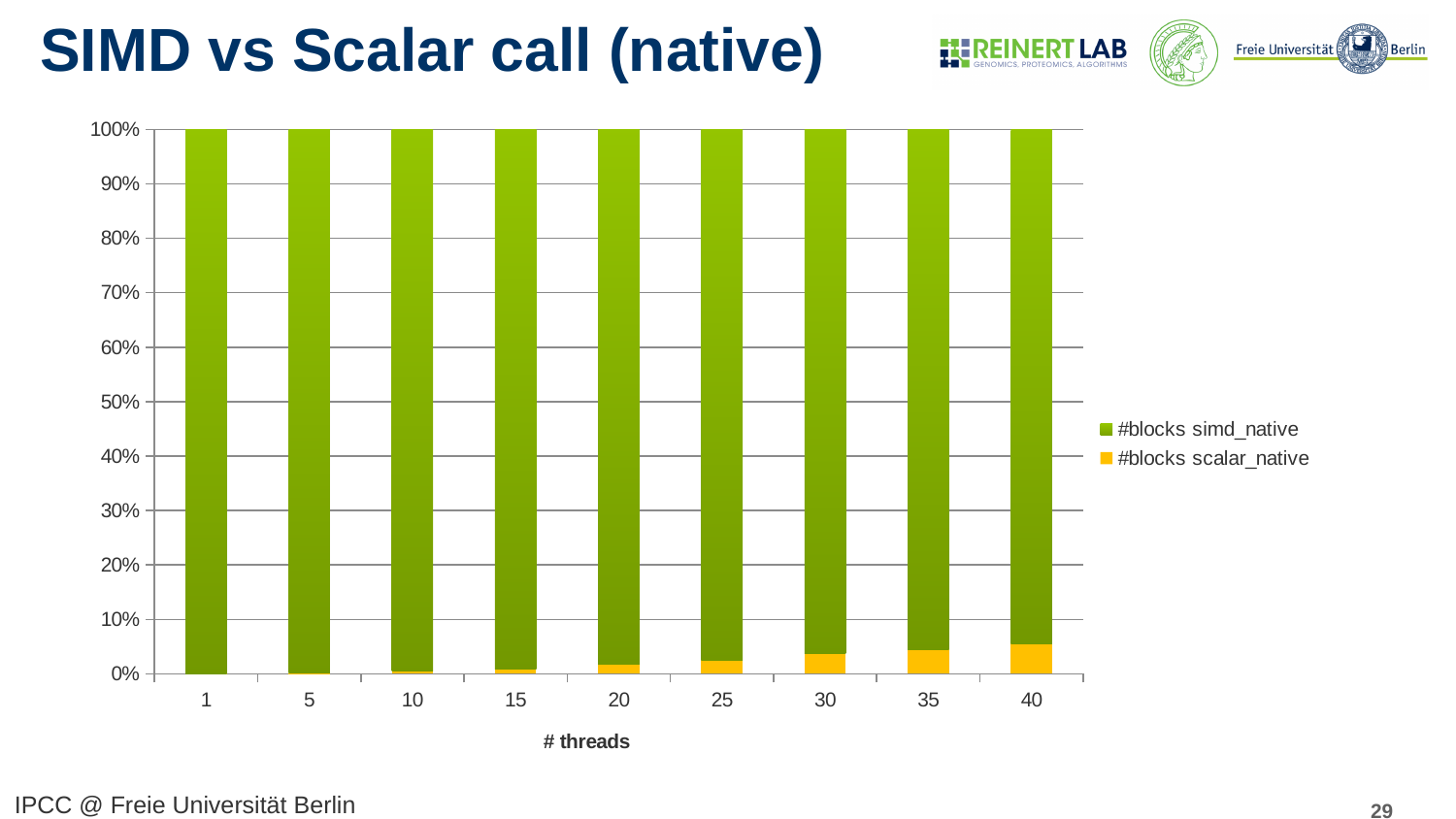
What is the title of the x axis? # threads How many thread-count categories are shown on the x axis? 9 Does the share of #blocks scalar_native rise or fall as the number of threads increases? rises At which thread count is the share of #blocks scalar_native highest? 40 How many series does the legend list? 2 Which series is drawn in yellow? #blocks scalar_native Is the share of #blocks simd_native at 40 threads greater or less than 90%? greater At which thread count is the share of #blocks scalar_native lowest? 1 What kind of chart is shown on the slide? stacked bar chart What is the total height of the stacked bar at 20 threads? 100% Is the share of #blocks scalar_native at 40 threads greater or less than 10%? less Which is larger: the share of #blocks scalar_native at 40 threads or at 5 threads? 40 threads